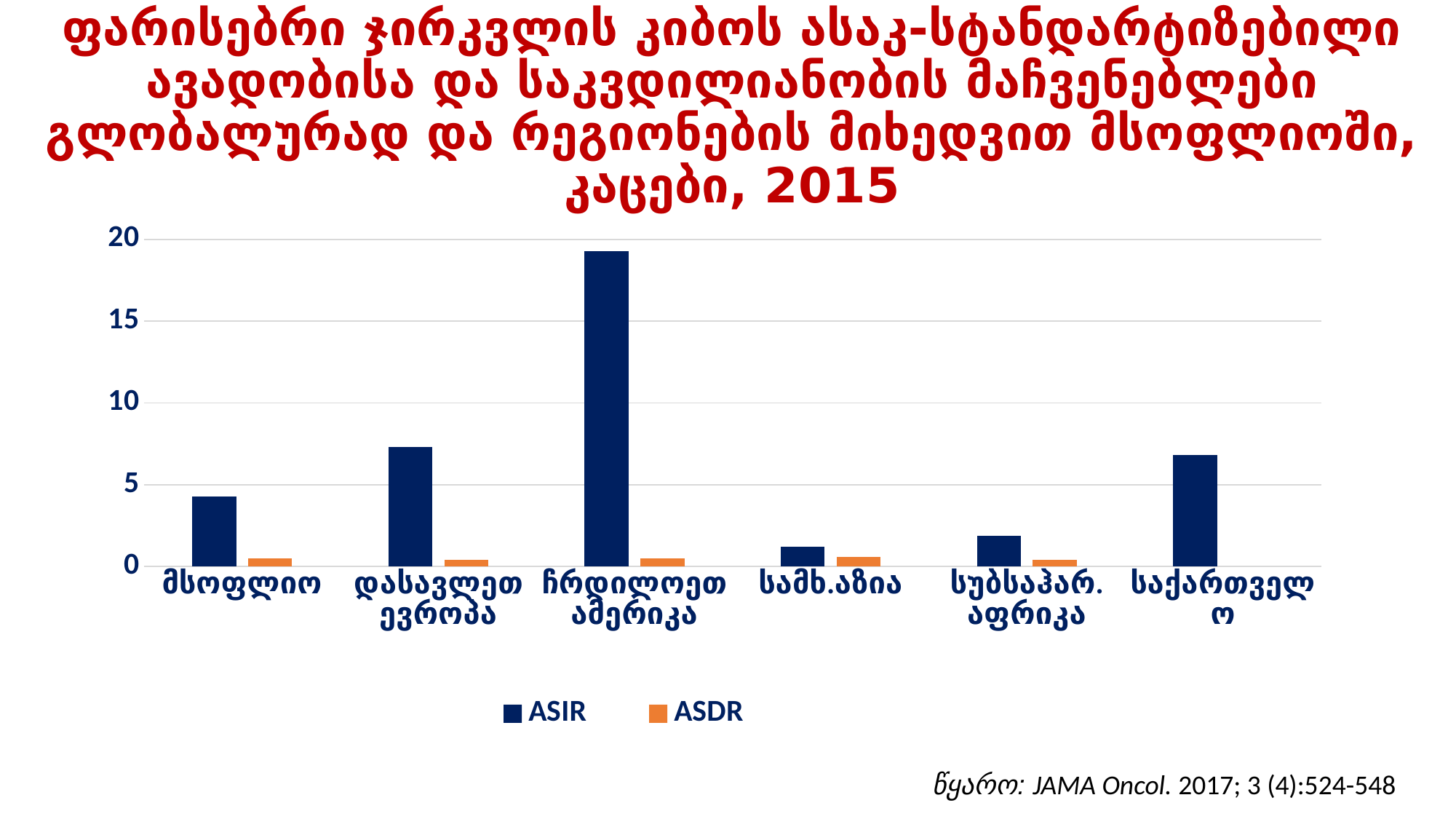
How many series does the legend list? 2 Which category has the lowest ASIR value? სამხ.აზია What kind of chart is shown on the slide? bar chart Which series is shown in orange in the legend? ASDR Is the ASIR value for მსოფლიო greater or less than 5? less Is the ASIR value for ჩრდილოეთ ამერიკა greater or less than 15? greater What year is stated in the chart title? 2015 Which category has the highest ASIR value? ჩრდილოეთ ამერიკა Which is larger, the ASIR value for დასავლეთ ევროპა or the ASIR value for საქართველო? დასავლეთ ევროპა Is the ASIR value for დასავლეთ ევროპა greater or less than 5? greater How many categories are shown on the x axis? 6